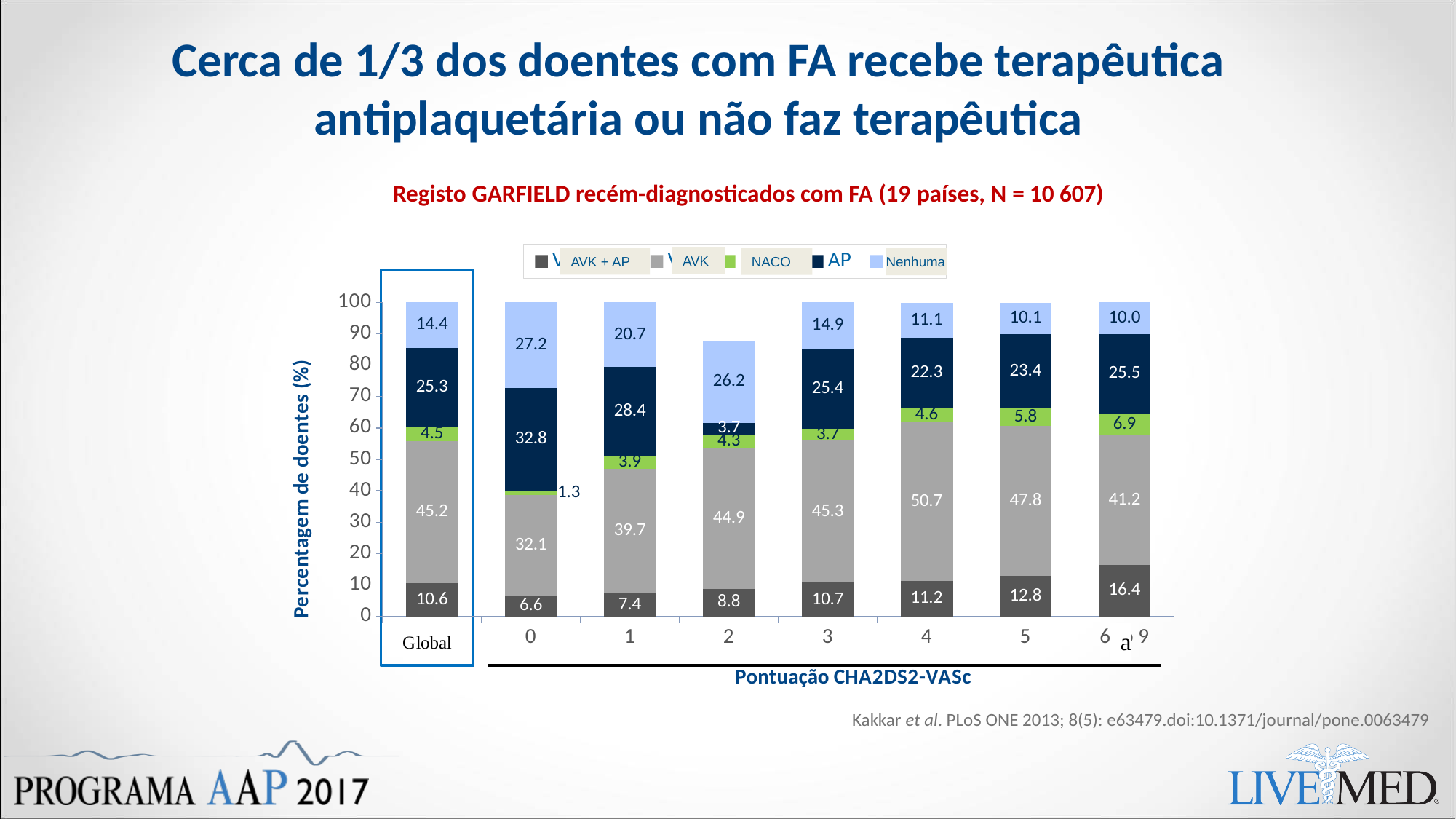
What is the Nenhuma value for CHA2DS2-VASc score 0? 27.2 How many series does the legend list? 5 Which has a larger AVK value, CHA2DS2-VASc score 4 or score 5? Score 4 How many bars are shown in the chart? 8 What kind of chart is shown on the slide? Stacked bar chart Which CHA2DS2-VASc score category has the highest Nenhuma value? 0 What is the AVK + AP value for the rightmost bar (CHA2DS2-VASc score 6 a 9)? 16.4 What is the AVK value for the Global bar? 45.2 What is the NACO value for CHA2DS2-VASc score 0? 1.3 What is the difference between the AP value for score 1 and the AP value for score 2? 24.7 Which CHA2DS2-VASc score category has the lowest AVK + AP value? 0 Does the AVK + AP value rise or fall as the CHA2DS2-VASc score increases from 0 to 6 a 9? Rises